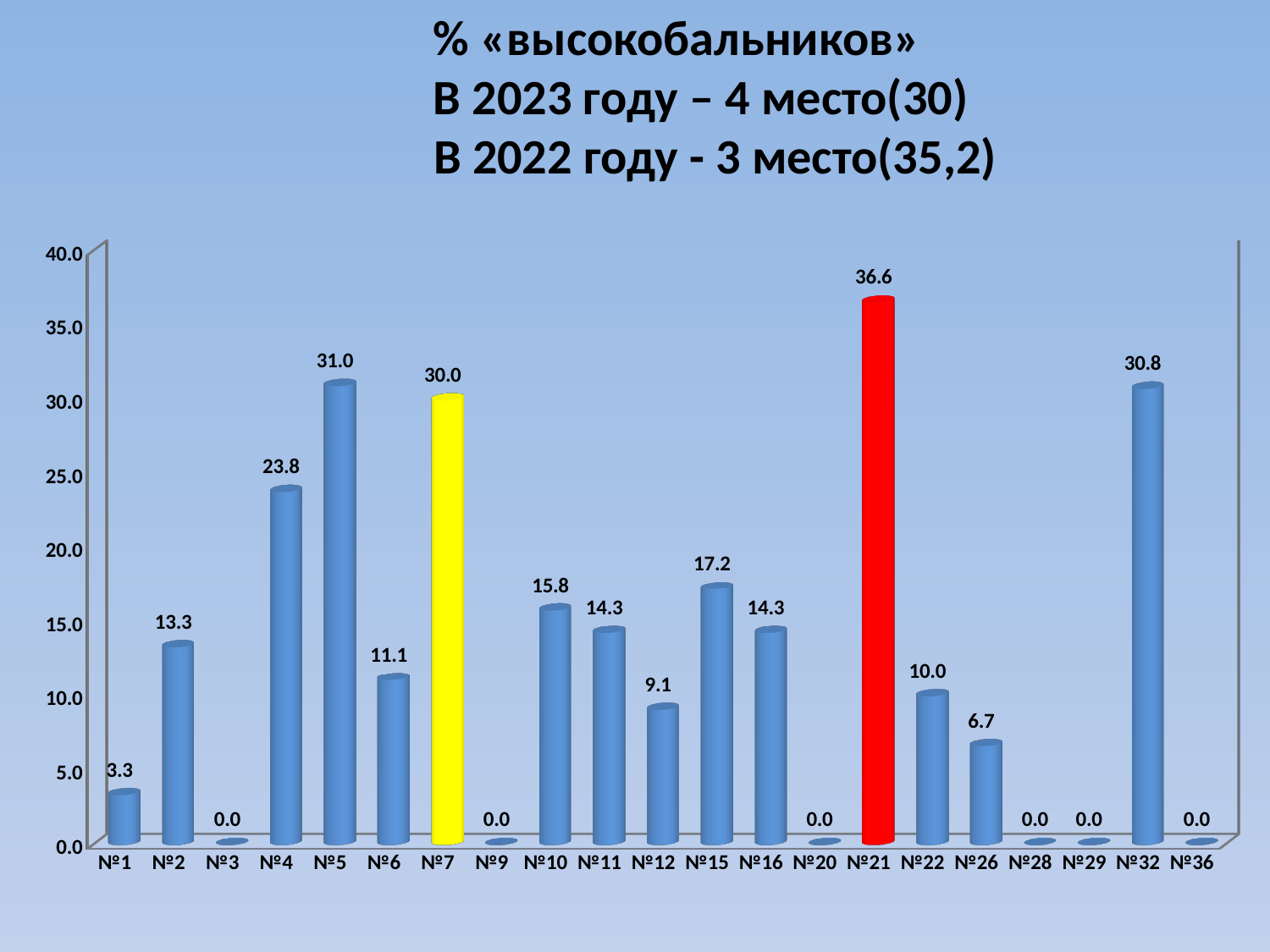
What is the value for №26? 6.7 Which category's bar is coloured red? №21 What is the value for №7? 30.0 How many categories are shown on the x axis? 21 What is the difference between the values for №21 and №32? 5.8 What is the value for №4? 23.8 What is the value for №21? 36.6 What kind of chart is this? bar chart What is the difference between the values for №5 and №7? 1.0 Which is larger, the value for №10 or the value for №15? №15 How many categories have a value of 0.0? 6 Which category has the highest value? №21